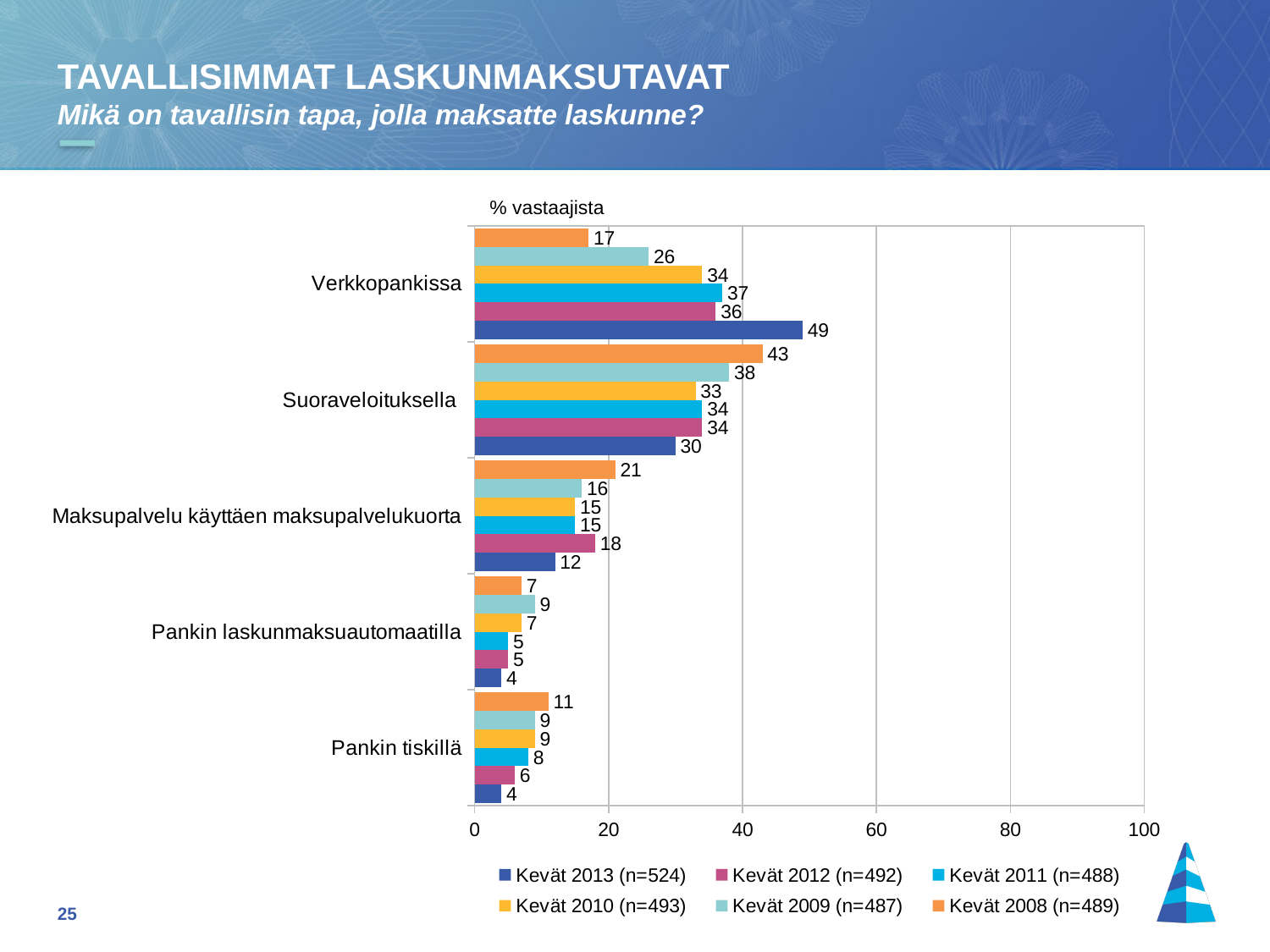
What is the value for Maksupalvelu käyttäen maksupalvelukuorta in the Kevät 2009 (n=487) series? 16 What is the label shown above the chart's plot area? % vastaajista What is the difference between the Kevät 2013 (n=524) and Kevät 2008 (n=489) values for Verkkopankissa? 32 For Suoraveloituksella, which is larger: the Kevät 2008 (n=489) value or the Kevät 2013 (n=524) value? Kevät 2008 (n=489) What is the value for Suoraveloituksella in the Kevät 2008 (n=489) series? 43 How many categories are shown on the chart? 5 What is the value for Verkkopankissa in the Kevät 2013 (n=524) series? 49 What kind of chart is shown on the slide? Bar chart Which category has the lowest value in the Kevät 2008 (n=489) series? Pankin laskunmaksuautomaatilla How many series does the legend list? 6 What is the value for Pankin tiskillä in the Kevät 2012 (n=492) series? 6 Which category has the highest value in the Kevät 2013 (n=524) series? Verkkopankissa